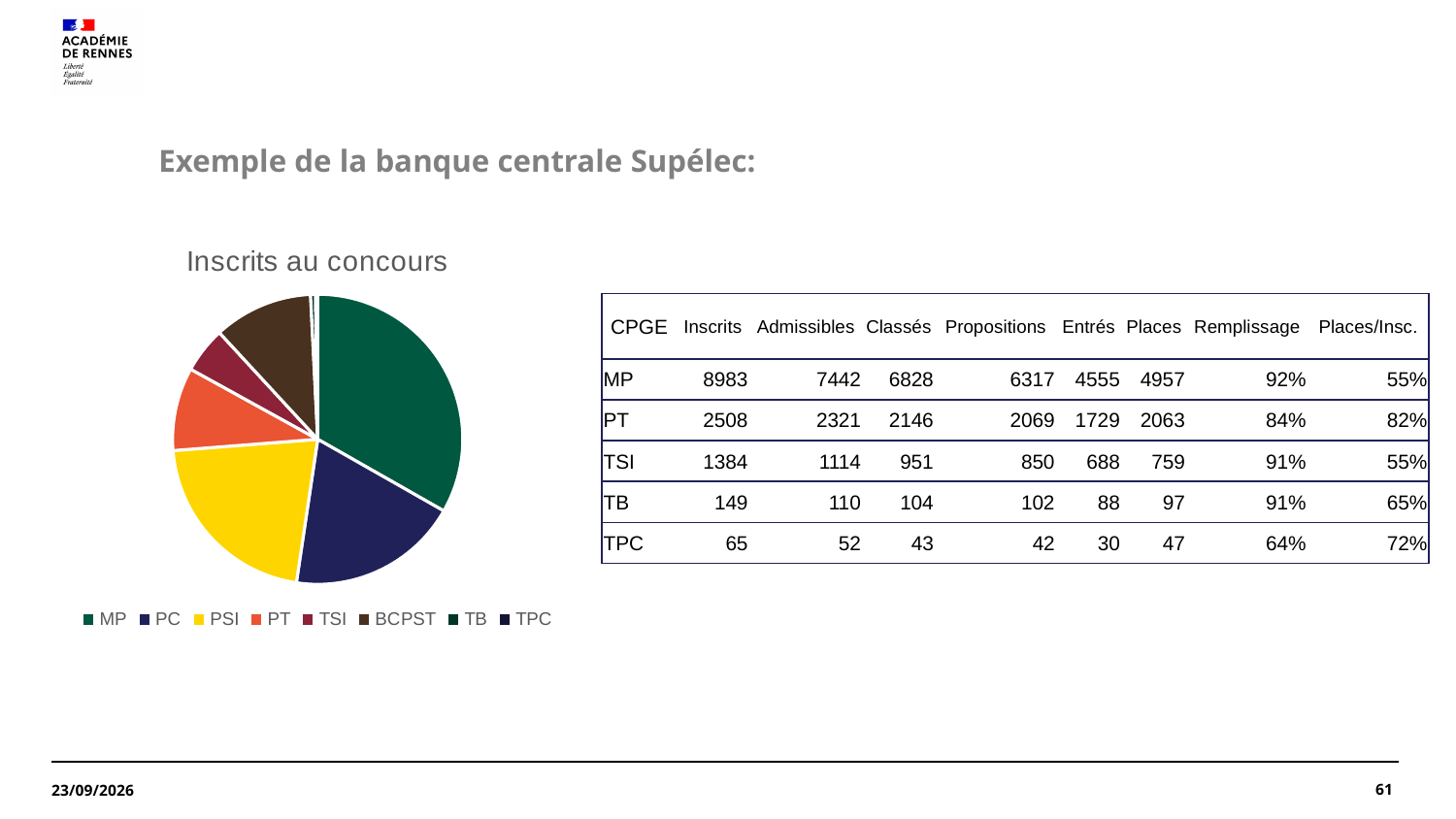
What is the title of the pie chart on the slide? Inscrits au concours In the pie chart, which slice is larger, PC or PT? PC What colour is the MP slice in the pie chart? dark green In the pie chart, which slice is larger, PSI or TSI? PSI In the pie chart, which slice is larger, MP or PSI? MP Which category has the largest slice in the pie chart? MP Which category is listed first in the pie chart's legend? MP What kind of chart is shown under the title "Inscrits au concours"? pie chart How many categories does the legend of the pie chart list? 8